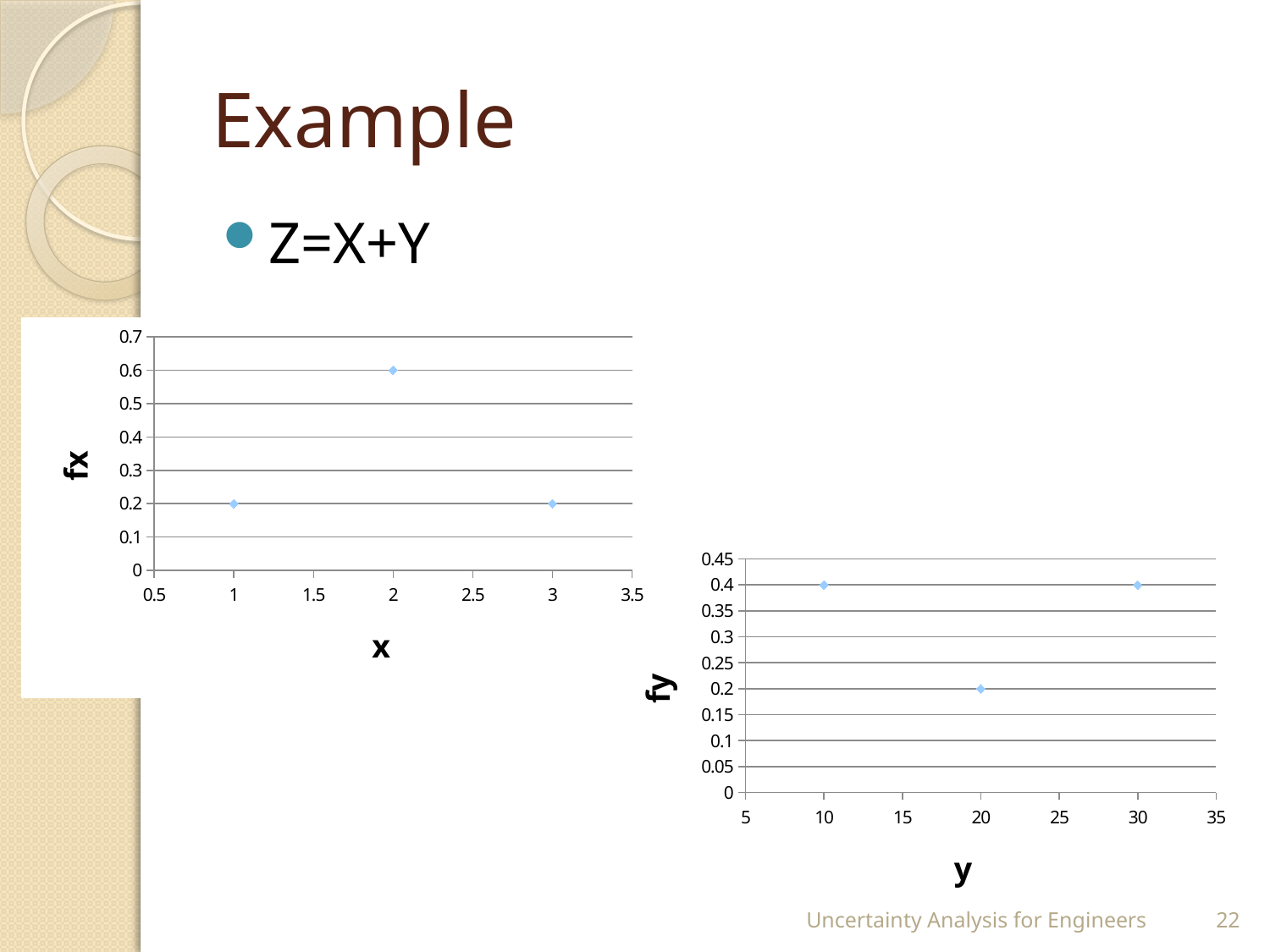
In the left chart (fx vs x), what is the value of fx at x = 2? 0.6 In the right chart (fy vs y), which is larger: fy at y = 10 or fy at y = 20? fy at y = 10 In the right chart (fy vs y), at which y value is fy lowest? 20 In the right chart (fy vs y), how many data points are plotted? 3 What kind of chart is the left chart (fx vs x)? scatter chart In the left chart (fx vs x), at which x value is fx highest? 2 In the left chart (fx vs x), what is the value of fx at x = 1? 0.2 In the left chart (fx vs x), how many data points are plotted? 3 In the right chart (fy vs y), what is the value of fy at y = 20? 0.2 In the right chart (fy vs y), what is the value of fy at y = 30? 0.4 In the left chart (fx vs x), what is the difference between fx at x = 2 and fx at x = 3? 0.4 What is the label of the vertical axis on the right chart? fy